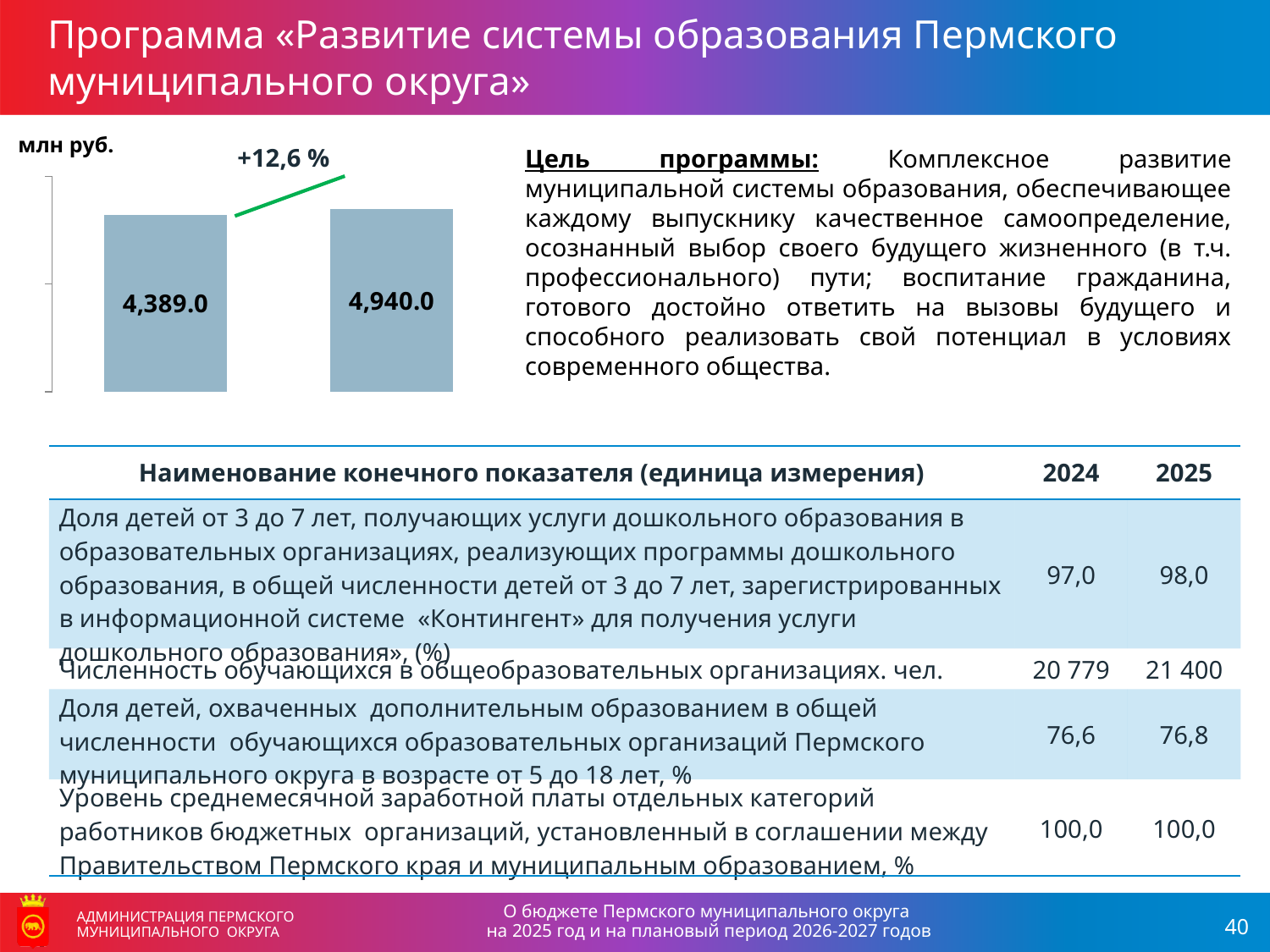
Is the value of the right bar larger or smaller than the value of the left bar? larger What is the difference between the right bar and the left bar in the chart? 551.0 Which bar in the chart has the higher value, the left or the right? the right bar What percentage change is annotated above the bars in the chart? +12,6 % Do the values in the chart rise or fall from left to right? rise Which bar in the chart has the lower value, the left or the right? the left bar How many bars are plotted in the chart? 2 What is the value of the right bar in the chart? 4,940.0 What is the value of the left bar in the chart? 4,389.0 What kind of chart is shown on the slide? bar chart What unit is indicated in the top-left corner of the chart? млн руб.